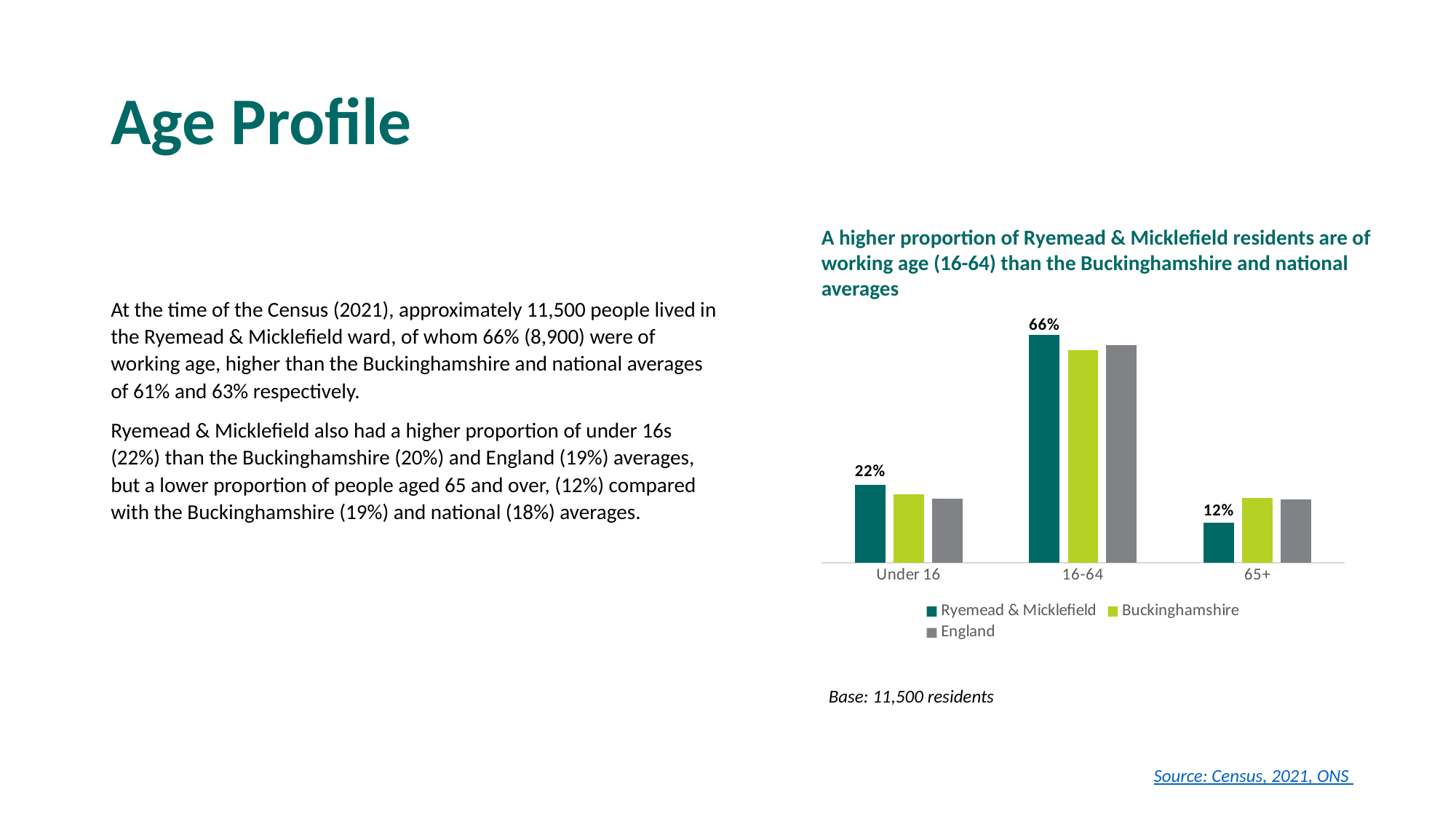
What is the value for Ryemead & Micklefield in the Under 16 age group? 22% In the Under 16 age group, which is larger: Ryemead & Micklefield or Buckinghamshire? Ryemead & Micklefield What is the value for Ryemead & Micklefield in the 65+ age group? 12% In the 65+ age group, which is larger: Ryemead & Micklefield or England? England What is the difference between the Ryemead & Micklefield values for Under 16 and 65+? 10 percentage points Which age group has the lowest value for Ryemead & Micklefield? 65+ What kind of chart is shown on the slide? Bar chart How many age groups are shown on the x axis of the chart? 3 How many series does the chart legend list? 3 What is the value for Ryemead & Micklefield in the 16-64 age group? 66% What is the difference between the Ryemead & Micklefield values for 16-64 and Under 16? 44 percentage points Which age group has the highest value for Ryemead & Micklefield? 16-64